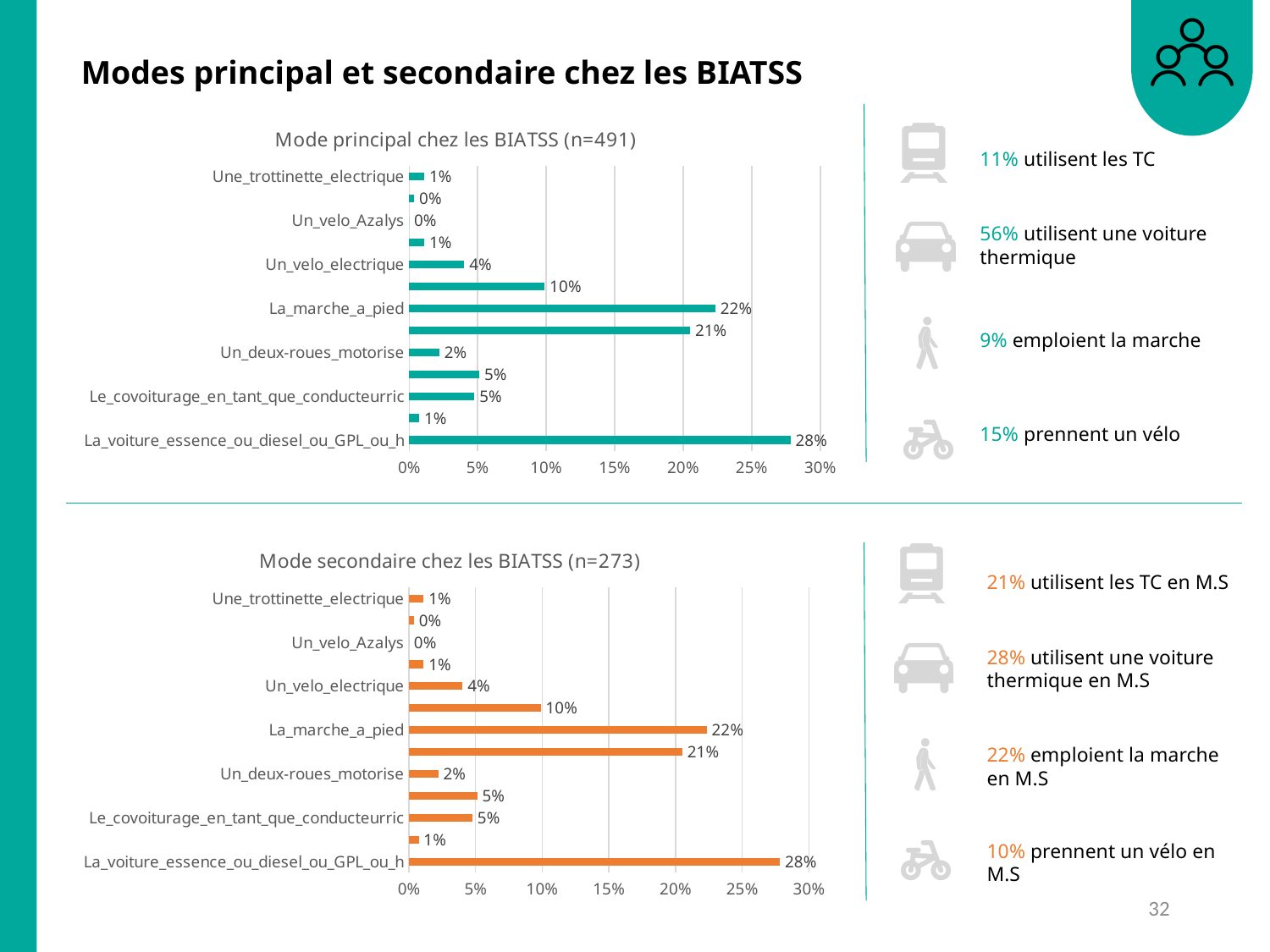
In the chart titled "Mode secondaire chez les BIATSS (n=273)", what is the value for Un_deux-roues_motorise? 2% What type of chart is the chart titled "Mode secondaire chez les BIATSS (n=273)"? Bar chart In the chart titled "Mode secondaire chez les BIATSS (n=273)", what is the value for Le_covoiturage_en_tant_que_conducteurric? 5% In the chart titled "Mode principal chez les BIATSS (n=491)", which is larger: Le_covoiturage_en_tant_que_conducteurric or Un_deux-roues_motorise? Le_covoiturage_en_tant_que_conducteurric In the chart titled "Mode principal chez les BIATSS (n=491)", what is the value for Un_velo_electrique? 4% In the chart titled "Mode secondaire chez les BIATSS (n=273)", how many bars are plotted? 13 In the chart titled "Mode secondaire chez les BIATSS (n=273)", what is the value for Un_velo_Azalys? 0% In the chart titled "Mode principal chez les BIATSS (n=491)", which category has the highest value? La_voiture_essence_ou_diesel_ou_GPL_ou_h In the chart titled "Mode principal chez les BIATSS (n=491)", what is the value for La_voiture_essence_ou_diesel_ou_GPL_ou_h? 28% In the chart titled "Mode principal chez les BIATSS (n=491)", what is the value for La_marche_a_pied? 22% What colour are the bars in the chart titled "Mode secondaire chez les BIATSS (n=273)"? Orange In the chart titled "Mode principal chez les BIATSS (n=491)", what is the difference between the values for La_voiture_essence_ou_diesel_ou_GPL_ou_h and La_marche_a_pied? 6%